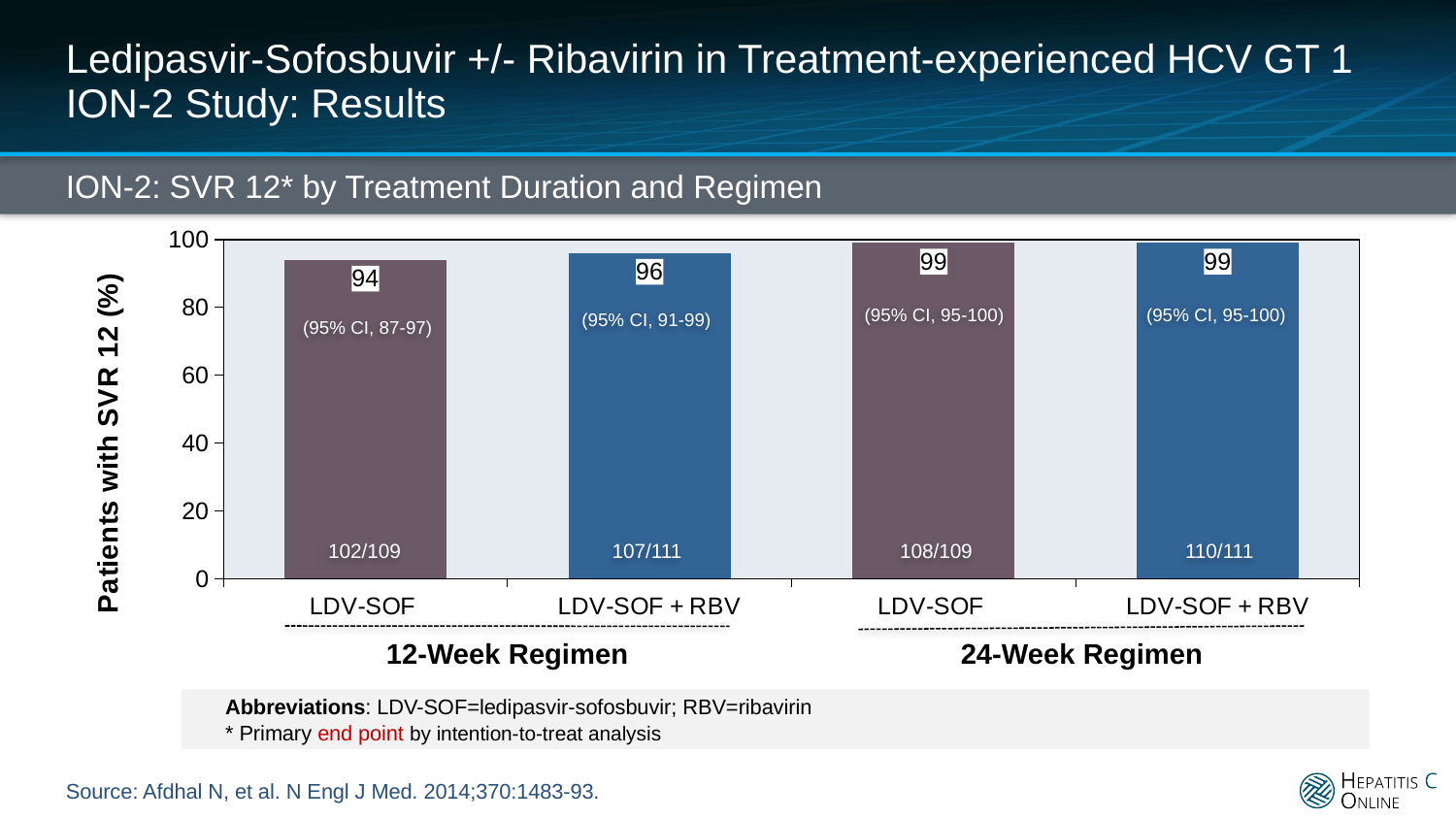
Which bar has the lowest SVR 12 rate? LDV-SOF, 12-Week Regimen What is the SVR 12 rate for LDV-SOF + RBV in the 12-week regimen? 96 What is the SVR 12 rate for LDV-SOF in the 24-week regimen? 99 What is the 95% confidence interval shown for LDV-SOF + RBV in the 12-week regimen? 95% CI, 91-99 How many patients achieved SVR 12 out of the total for LDV-SOF + RBV in the 24-week regimen, as printed on the bar? 110/111 What is the difference in SVR 12 rate between LDV-SOF in the 24-week regimen and LDV-SOF in the 12-week regimen? 5 In the 12-week regimen, which has the higher SVR 12 rate, LDV-SOF or LDV-SOF + RBV? LDV-SOF + RBV What is the label of the y-axis? Patients with SVR 12 (%) How many bars are shown in the chart? 4 What is the difference in SVR 12 rate between LDV-SOF + RBV and LDV-SOF in the 12-week regimen? 2 What kind of chart is shown on the slide? Bar chart What is the SVR 12 rate for LDV-SOF in the 12-week regimen? 94